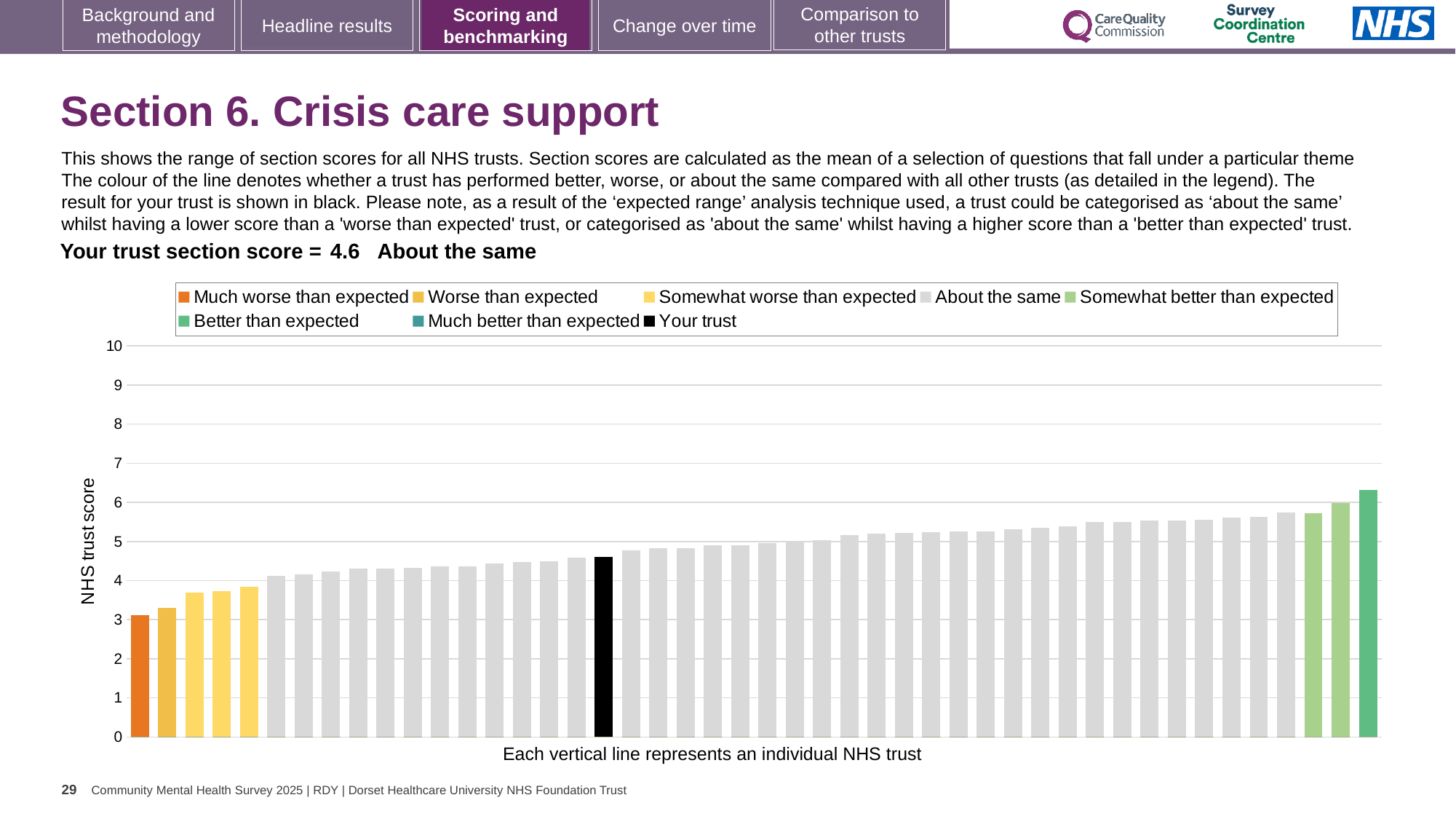
Is the value of the black 'Your trust' bar greater or less than 4? greater Is the value of the tallest bar in the chart greater or less than 6? greater How many bars are coloured as 'Somewhat better than expected'? 2 What is the label on the vertical axis of the chart? NHS trust score Which is larger, the black 'Your trust' bar or the orange 'Much worse than expected' bar? Your trust Do the bar values rise or fall from left to right along the x axis? rise How many bars are coloured as 'Somewhat worse than expected'? 3 How many entries does the chart legend list? 8 Is the value of the shortest (orange) bar greater or less than 4? less What kind of chart is shown on the slide? bar chart What is the section score for your trust shown on the slide? 4.6 How many bars are coloured as 'Much worse than expected'? 1